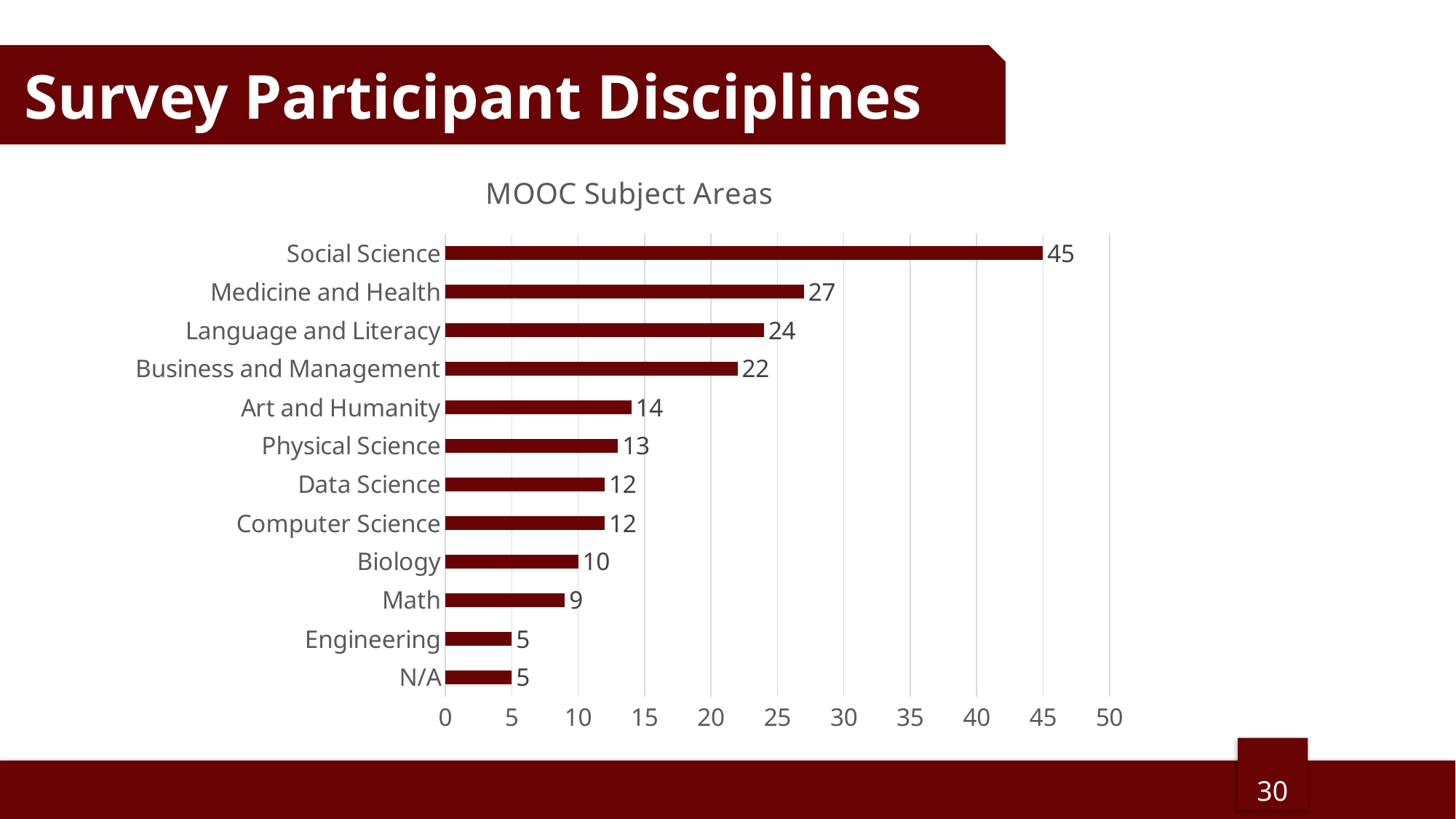
What is the highest value shown on the horizontal axis? 50 What is the difference between the values for Language and Literacy and Math? 15 What is the title of the chart? MOOC Subject Areas How many subject areas are shown in the chart? 12 Which subject area has the highest value? Social Science What is the difference between the values for Social Science and Medicine and Health? 18 What is the value for Social Science? 45 Is the value for Medicine and Health greater or less than 25? greater What is the value for Biology? 10 What is the value for Business and Management? 22 What kind of chart is shown on the slide? bar chart Which is larger, the value for Art and Humanity or the value for Physical Science? Art and Humanity